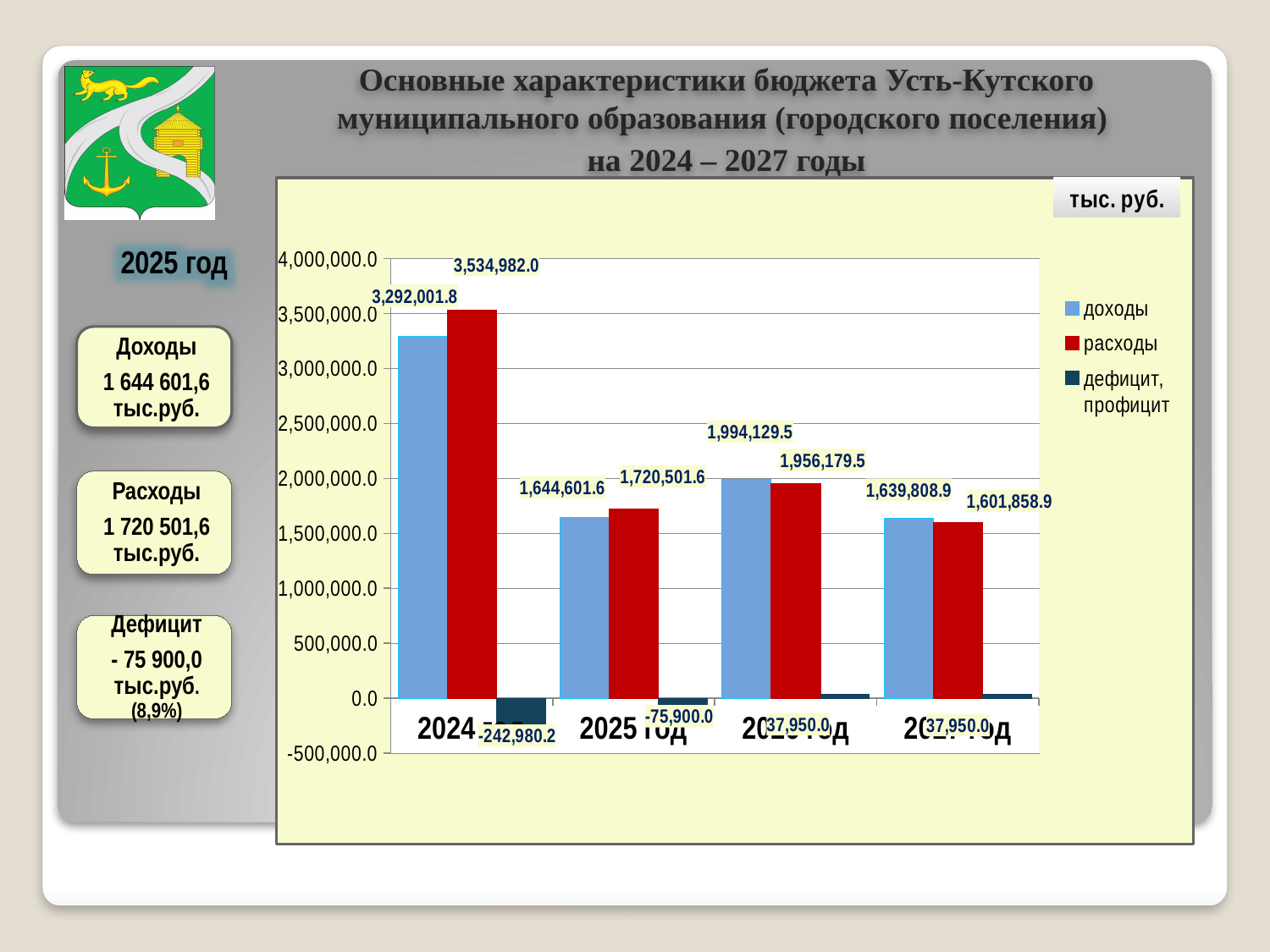
What is the value of расходы for 2025 год? 1,720,501.6 What is the value of доходы for 2026 год? 1,994,129.5 What is the value of доходы for 2024 год? 3,292,001.8 Which is larger for 2026 год, доходы or расходы? доходы In which year is доходы the highest? 2024 год How many series does the chart legend list? 3 In which year is расходы the lowest? 2027 год What unit is indicated in the box at the top right of the chart? тыс. руб. What is the value of дефицит, профицит for 2024 год? -242,980.2 What is the difference between расходы and доходы for 2024 год? 242,980.2 How many year categories are plotted on the x axis? 4 What type of chart is shown on the slide? bar chart